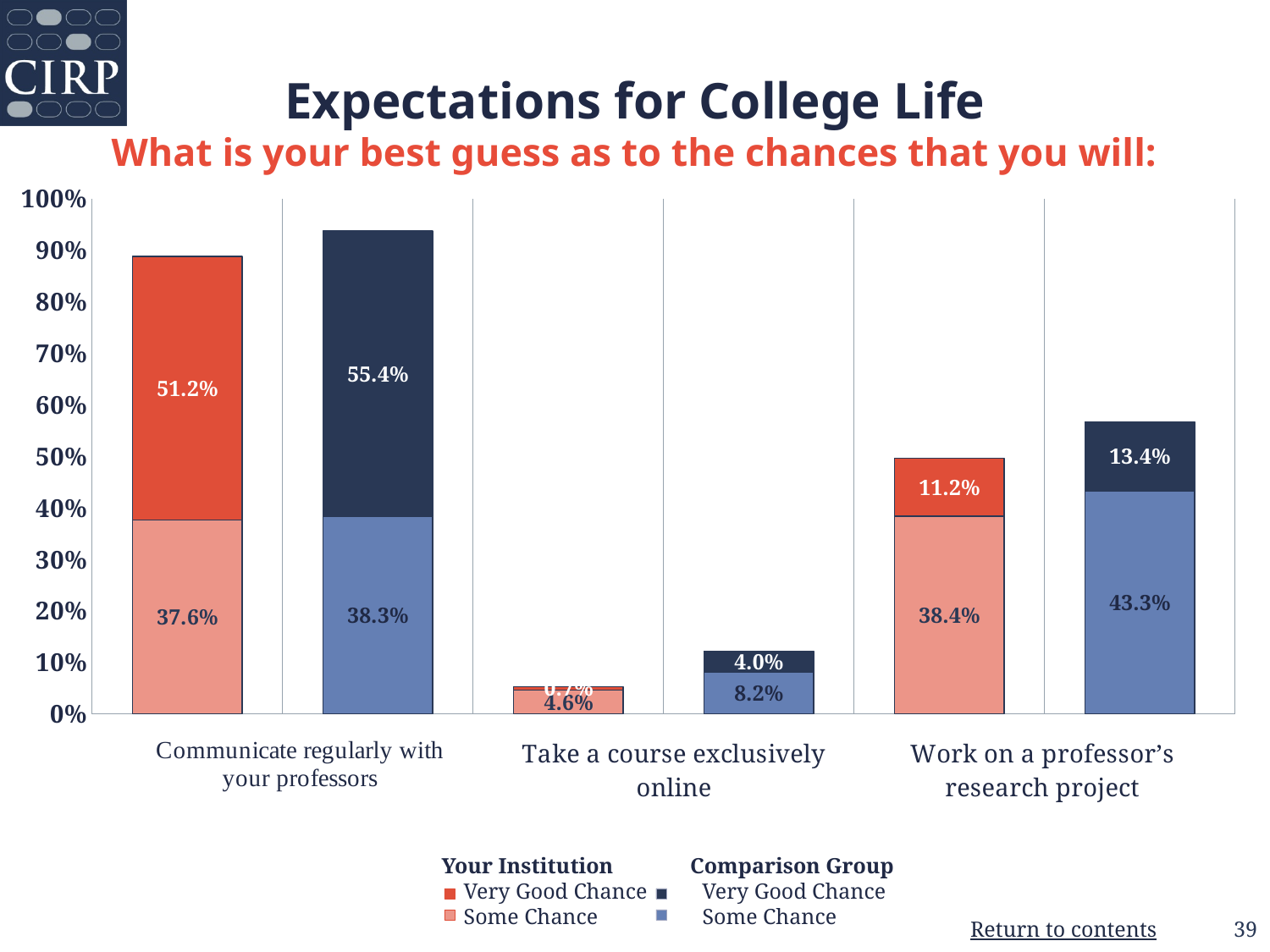
What type of chart is shown on the slide? Stacked bar chart What is the total stacked value of the Your Institution bar for working on a professor's research project? 49.6% Which category has the highest Very Good Chance value for the Comparison Group? Communicate regularly with your professors What is the Comparison Group's Very Good Chance value for taking a course exclusively online? 4.0% What is Your Institution's Some Chance value for working on a professor's research project? 38.4% What is the total stacked value of the Comparison Group bar for communicating regularly with your professors? 93.7% What is the difference between the Comparison Group's and Your Institution's Very Good Chance values for communicating regularly with professors? 4.2% Which category has the lowest total stacked value for Your Institution? Take a course exclusively online What is the Comparison Group's Some Chance value for working on a professor's research project? 43.3% Which is larger: Your Institution's Some Chance value for communicating regularly with professors or the Comparison Group's Some Chance value for the same item? Comparison Group (38.3%) What percentage of students at Your Institution report a Very Good Chance that they will communicate regularly with their professors? 51.2% How many categories are shown on the x axis of the chart? 3